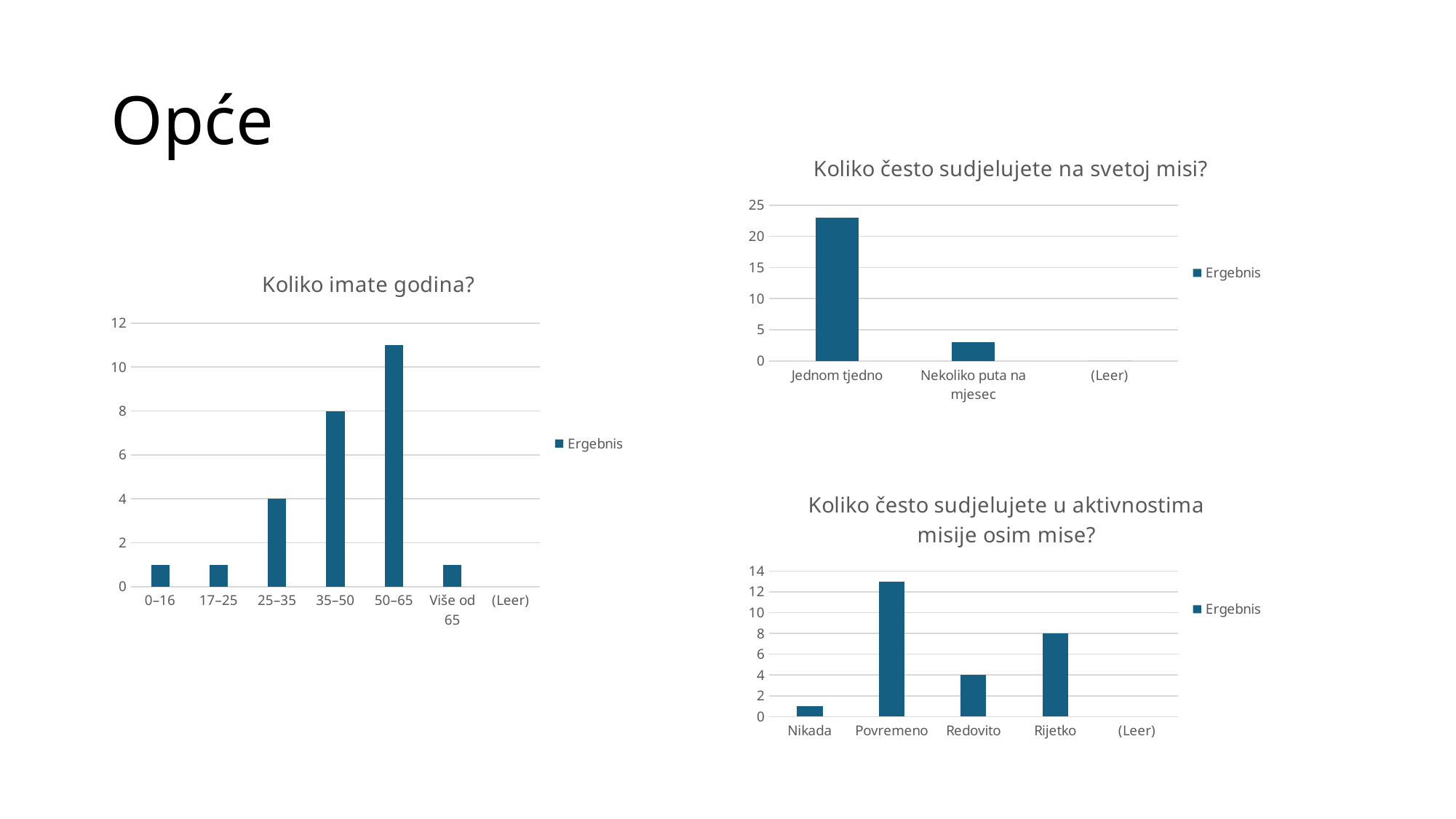
In the chart titled "Koliko imate godina?", which age category has the highest value? 50–65 In the chart titled "Koliko često sudjelujete na svetoj misi?", is the value for Nekoliko puta na mjesec greater or less than 5? less In the chart titled "Koliko često sudjelujete u aktivnostima misije osim mise?", which is larger, Povremeno or Rijetko? Povremeno In the chart titled "Koliko često sudjelujete u aktivnostima misije osim mise?", what is the value for Rijetko? 8 In the chart titled "Koliko često sudjelujete u aktivnostima misije osim mise?", what is the value for Redovito? 4 In the chart titled "Koliko imate godina?", is the value for 50–65 greater or less than 10? greater In the chart titled "Koliko imate godina?", how many categories are shown on the x axis? 7 In the chart titled "Koliko često sudjelujete na svetoj misi?", is the value for Jednom tjedno greater or less than 20? greater In the chart titled "Koliko imate godina?", what is the value for 35–50? 8 In the chart titled "Koliko često sudjelujete na svetoj misi?", which category has the highest value? Jednom tjedno What type of chart is the chart titled "Koliko često sudjelujete u aktivnostima misije osim mise?"? Bar chart In the chart titled "Koliko imate godina?", what is the value for 25–35? 4